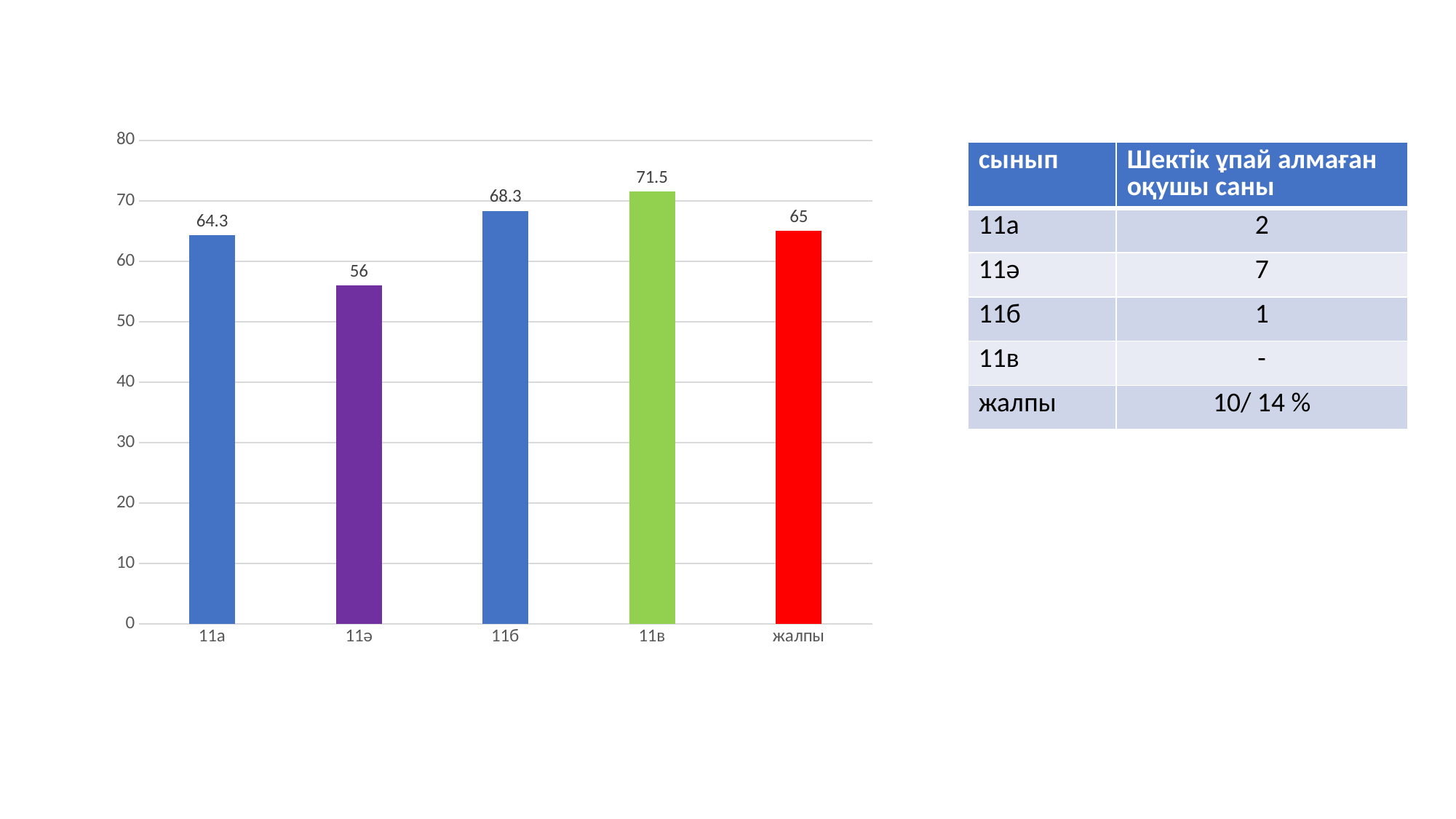
Which is larger, the value for 11а or the value for 11б? 11б What kind of chart is shown on the slide? bar chart What is the value for 11б? 68.3 What is the value for 11в? 71.5 What is the value for 11а? 64.3 What colour is the bar for жалпы? red Which category has the lowest value? 11ә How many categories are shown on the x axis? 5 Which category has the highest value? 11в What is the value for 11ә? 56 What is the value for жалпы? 65 What is the difference between the values for 11в and 11ә? 15.5